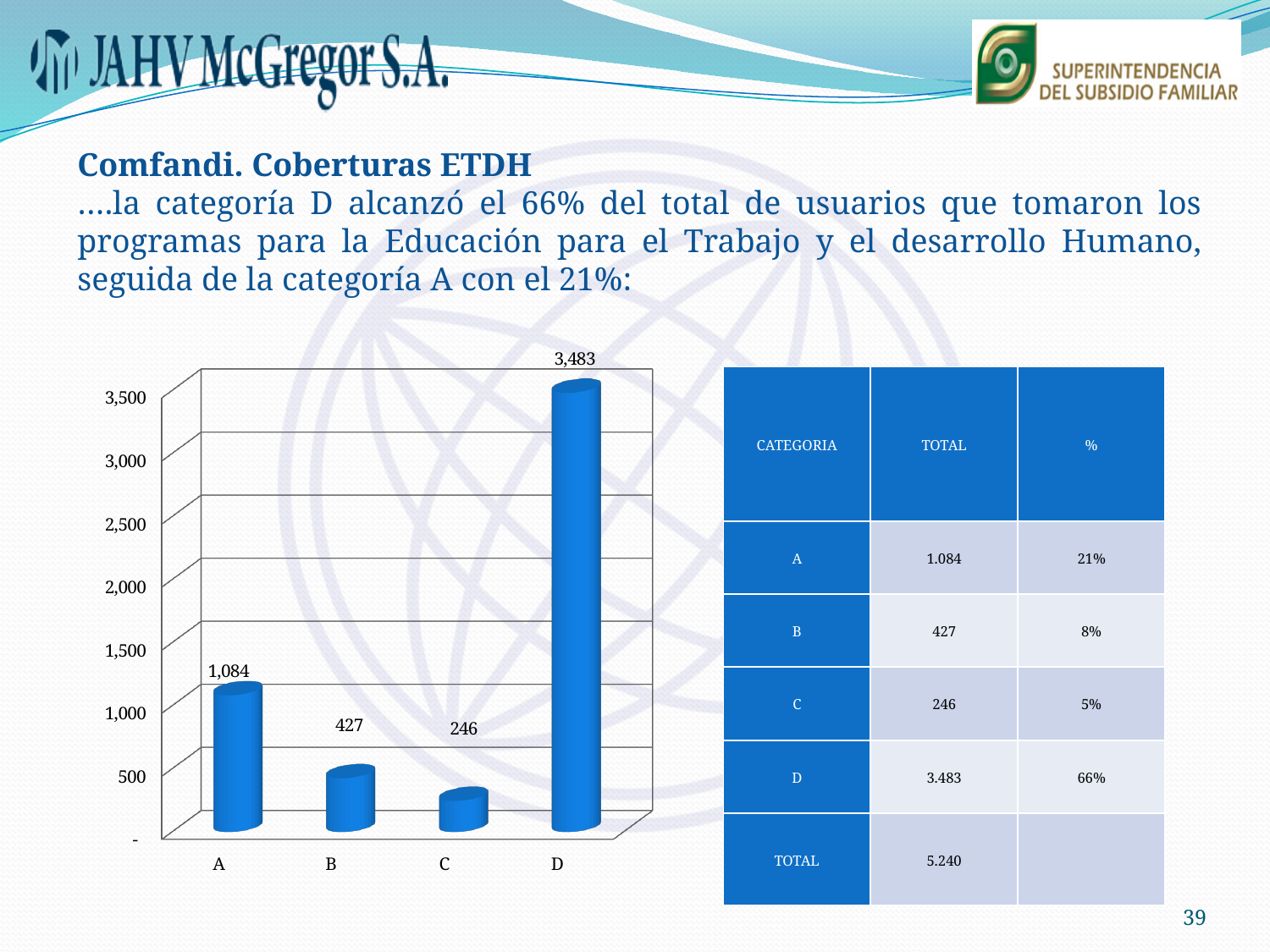
How many categories are shown in the bar chart? 4 What is the difference between the values for B and C in the bar chart? 181 Which category has the lowest value in the bar chart? C What is the value for category A in the bar chart? 1,084 What is the value for category C in the bar chart? 246 What kind of chart is shown on the slide? Bar chart What is the highest value shown on the vertical axis of the bar chart? 3,500 What is the value for category D in the bar chart? 3,483 Which is larger in the bar chart, the value for A or the value for B? A Which category has the highest value in the bar chart? D What is the value for category B in the bar chart? 427 What is the difference between the values for D and A in the bar chart? 2,399